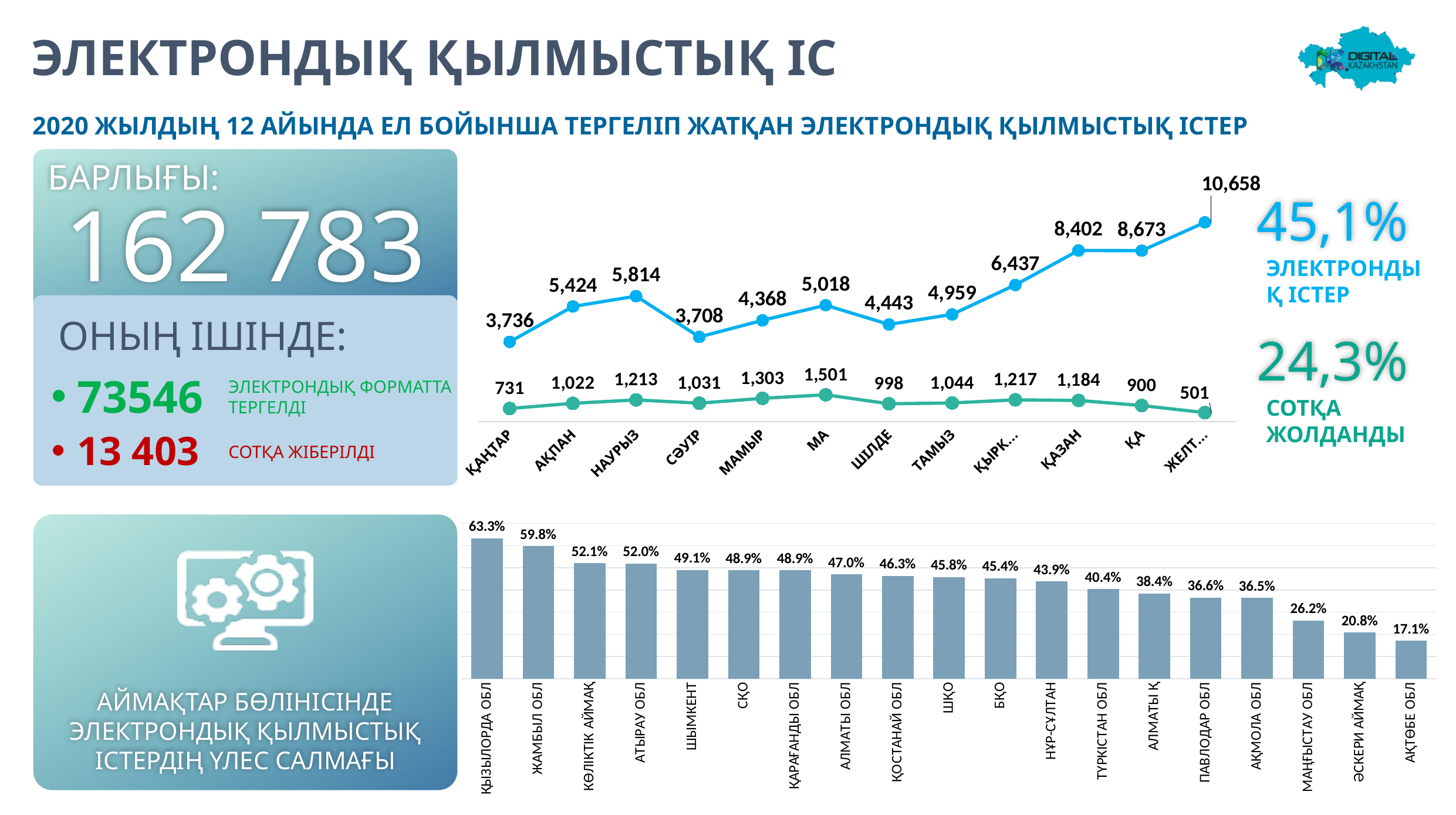
In the top line chart, which month has the lowest value in the green series? ЖЕЛТ... In the top line chart, what is the value of the blue series for ҚАҢТАР? 3,736 In the top line chart, how many months are plotted along the x axis? 12 In the top line chart, what is the difference between the blue series values for ҚАЗАН and ҚЫРК...? 1,965 In the top line chart, which month has the highest value in the blue series? ЖЕЛТ... In the bottom bar chart, which region has the highest value? ҚЫЗЫЛОРДА ОБЛ In the bottom bar chart, how many regions are shown? 19 What type of chart is the bottom chart on the slide? bar chart In the top line chart, what is the value of the green series for МАМЫР? 1,303 In the bottom bar chart, what is the value for ШЫМКЕНТ? 49.1% In the bottom bar chart, which region has the lowest value? АҚТӨБЕ ОБЛ What type of chart is the top chart on the slide? line chart